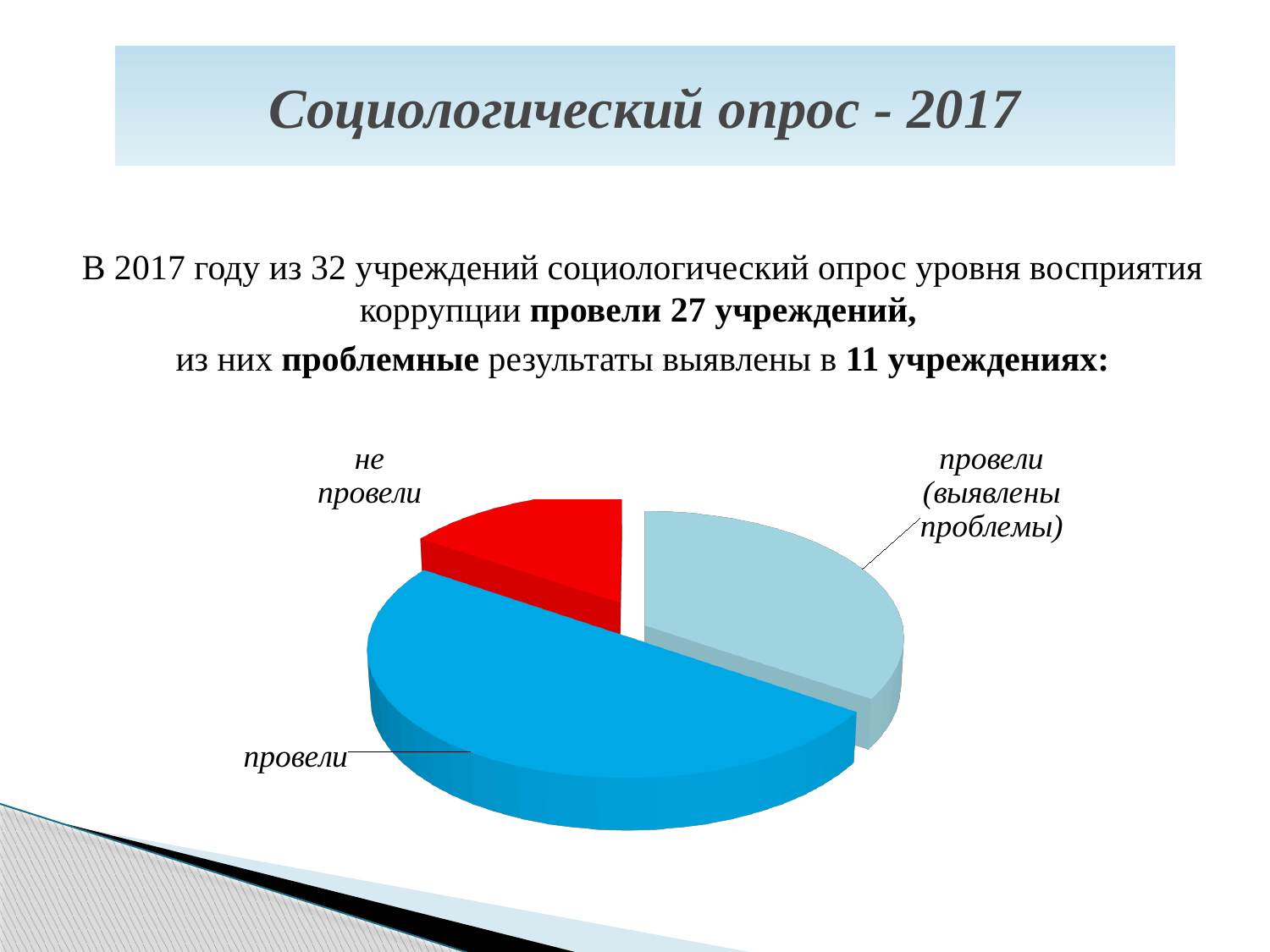
What is the title of the slide containing the pie chart? Социологический опрос - 2017 Which slice is larger: "провели" or "не провели"? провели What kind of chart is shown on the slide? pie chart Which slice of the pie chart is the largest? провели What colour is the "не провели" slice of the pie chart? red Which slice is larger: "провели" or "провели (выявлены проблемы)"? провели Which slice of the pie chart is the smallest? не провели How many slices does the pie chart have? 3 Which slice is larger: "провели (выявлены проблемы)" or "не провели"? провели (выявлены проблемы)